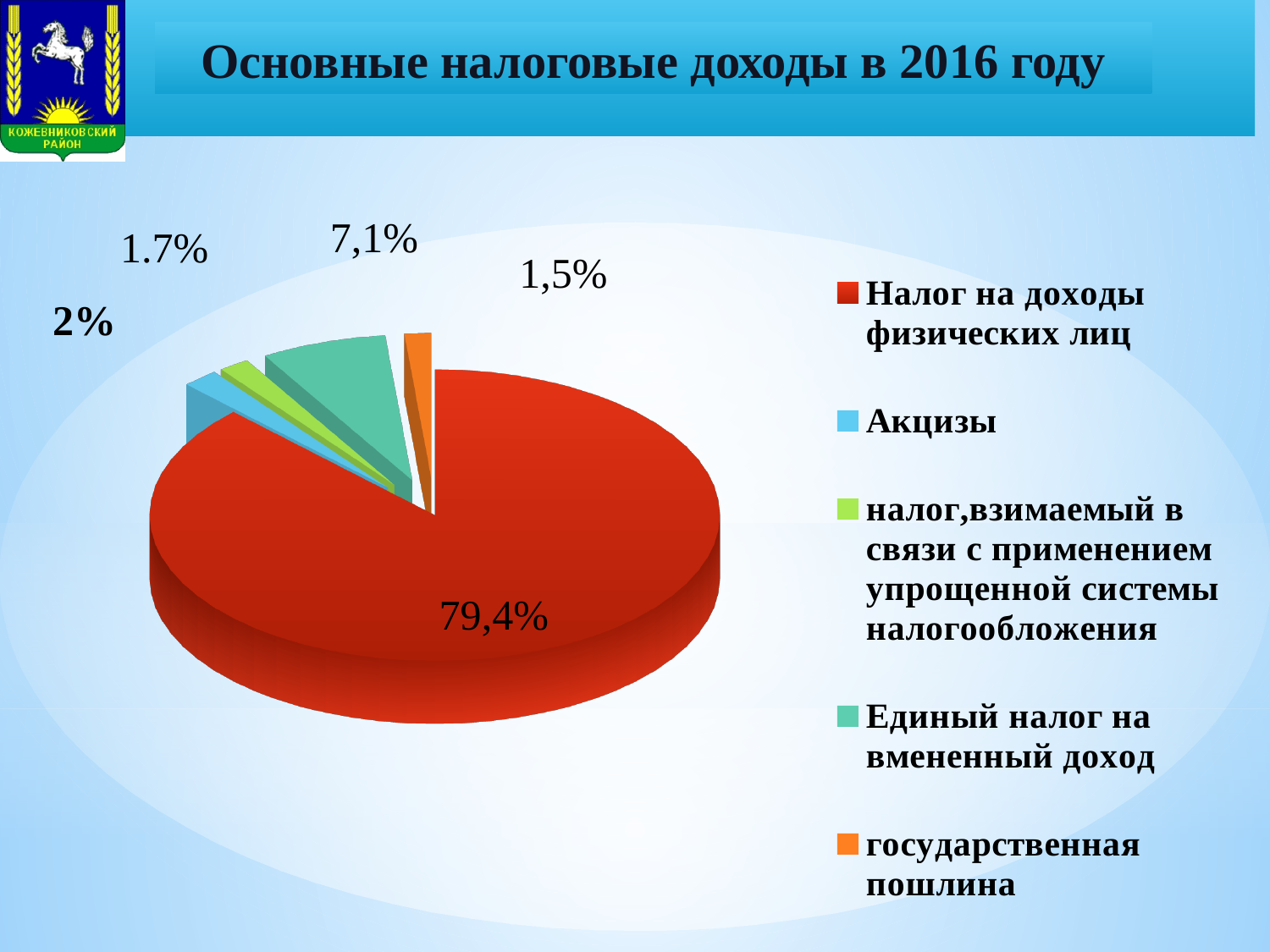
What share of the pie does "Акцизы" have? 2% What kind of chart is shown on the slide? pie chart What is the difference between the share for "Налог на доходы физических лиц" and the share for "Единый налог на вмененный доход"? 72,3% Which is larger: the share for "Акцизы" or the share for "Единый налог на вмененный доход"? Единый налог на вмененный доход What share of the pie does "государственная пошлина" have? 1,5% What is the title of the slide? Основные налоговые доходы в 2016 году What share of the pie does "Налог на доходы физических лиц" have? 79,4% Which category has the smallest slice of the pie? государственная пошлина What share of the pie does "Единый налог на вмененный доход" have? 7,1% What share of the pie does "налог,взимаемый в связи с применением упрощенной системы налогообложения" have? 1.7% Which category has the largest slice of the pie? Налог на доходы физических лиц How many slices does the pie chart have? 5